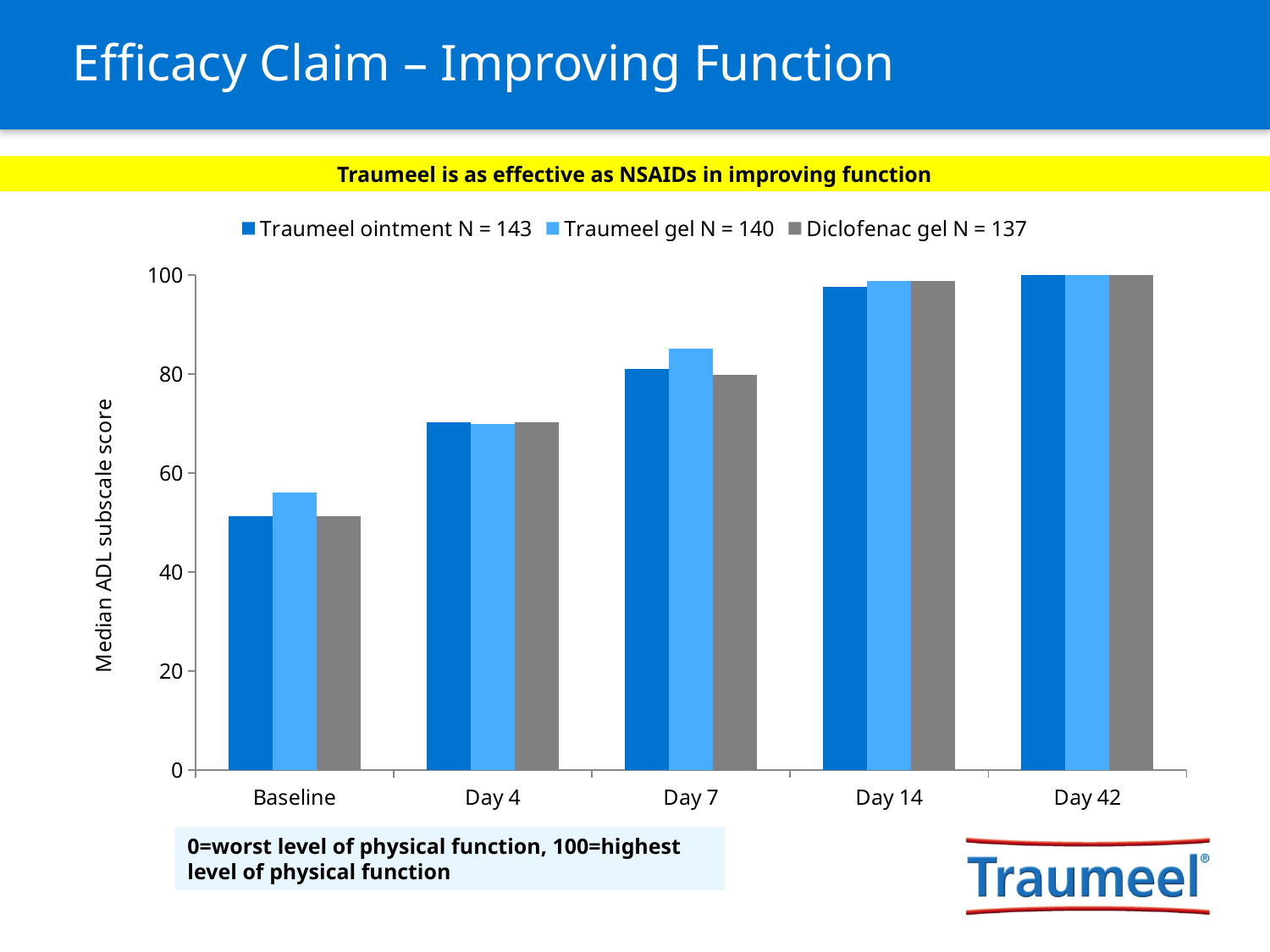
Is the value for Traumeel ointment at Baseline greater or less than 60? less Which series has the highest value at Baseline? Traumeel gel N = 140 Do the Median ADL subscale scores rise or fall from Baseline to Day 42? rise What is the Median ADL subscale score for Traumeel ointment at Day 42? 100 At Day 7, which is larger: the value for Traumeel gel or the value for Diclofenac gel? Traumeel gel How many time points (categories) are shown on the x axis? 5 Is the value for Diclofenac gel at Day 4 greater or less than 60? greater How many series does the legend list? 3 What is the label on the y axis of the chart? Median ADL subscale score Which series has the highest value at Day 7? Traumeel gel N = 140 Is the value for Traumeel gel at Day 7 greater or less than 80? greater What kind of chart is shown on the slide? bar chart